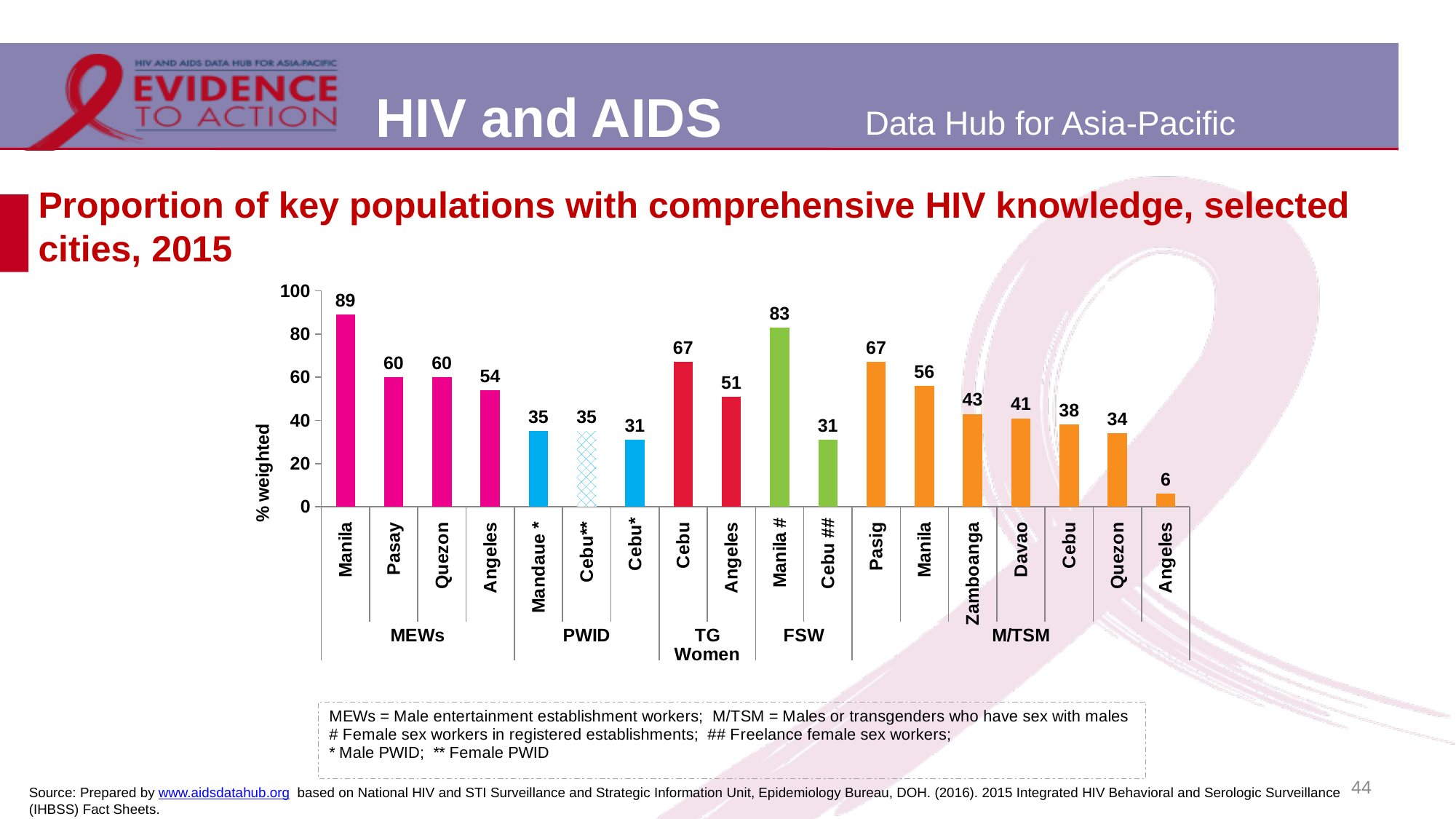
What is the value for Manila in the MEWs group? 89 How many bars are plotted in the chart? 18 How many bars are in the M/TSM group? 7 What is the difference between the values for Pasig and Manila in the M/TSM group? 11 What is the value for Zamboanga in the M/TSM group? 43 Which city has the highest value across the whole chart? Manila (MEWs) What is the value for Manila # in the FSW group? 83 Which city has the lowest value across the whole chart? Angeles (M/TSM) Which is larger: the value for Cebu in the TG Women group or the value for Angeles in the TG Women group? Cebu What is the label on the vertical axis of the chart? % weighted Is the value for Davao in the M/TSM group greater or less than 60? less What kind of chart is shown on the slide? Bar chart